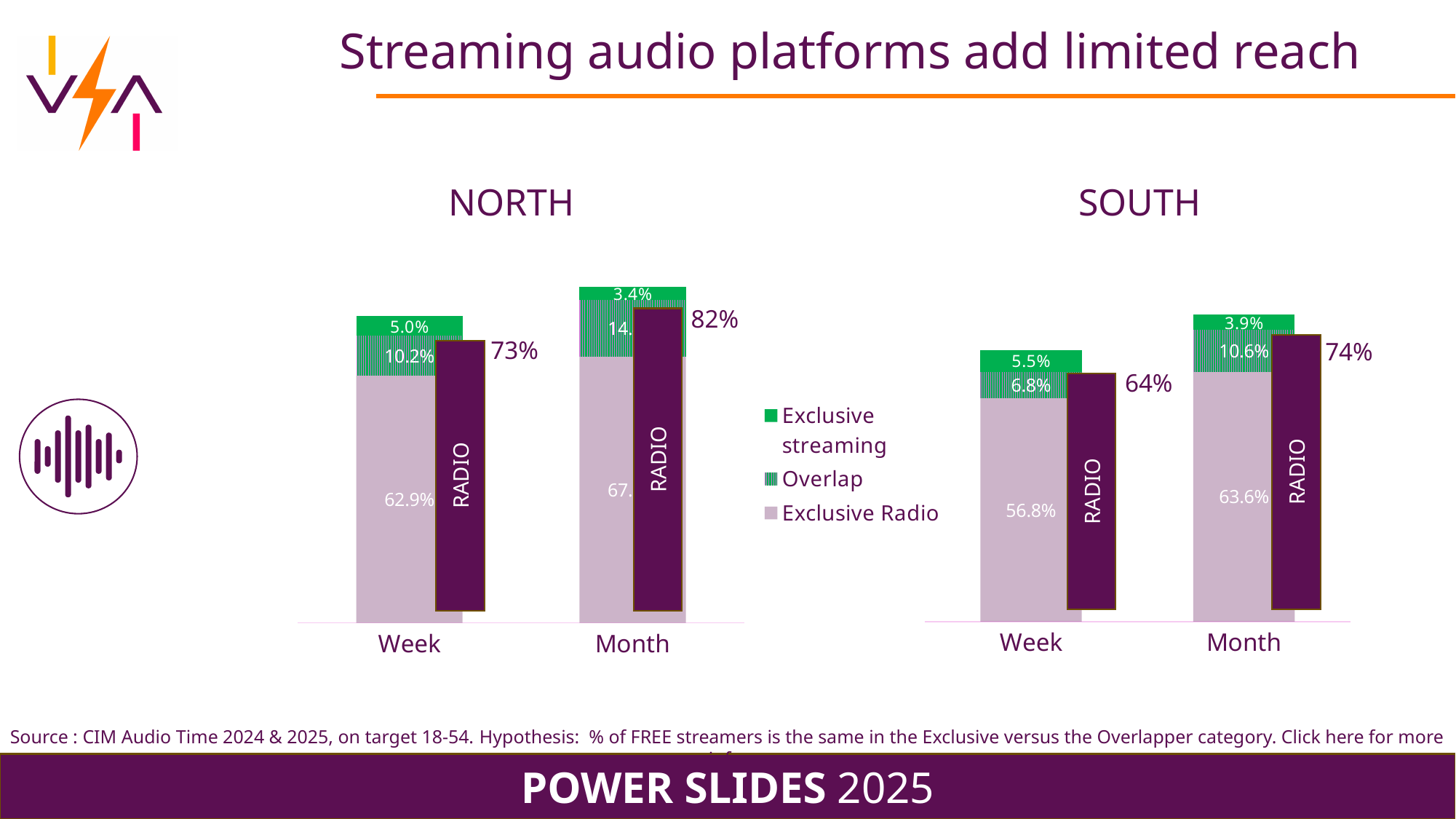
In the NORTH chart, which is larger, the Exclusive streaming value for Week or for Month? Week What kind of chart is the NORTH chart? Stacked bar chart In the SOUTH chart, what is the Exclusive streaming value for Week? 5.5% How many series does the legend list? 3 In the NORTH chart, what is the Exclusive Radio value for Week? 62.9% In the SOUTH chart, what is the difference between the Exclusive Radio values for Month and Week? 6.8% In the SOUTH chart, what is the Exclusive Radio value for Week? 56.8% In the SOUTH chart, what is the total of the stacked bar for Week? 69.1% In the NORTH chart, what is the Exclusive streaming value for Month? 3.4% In the NORTH chart, what is the Overlap value for Week? 10.2% In the SOUTH chart, what is the Overlap value for Month? 10.6% In the SOUTH chart, what RADIO reach percentage is shown next to the Month bar? 74%